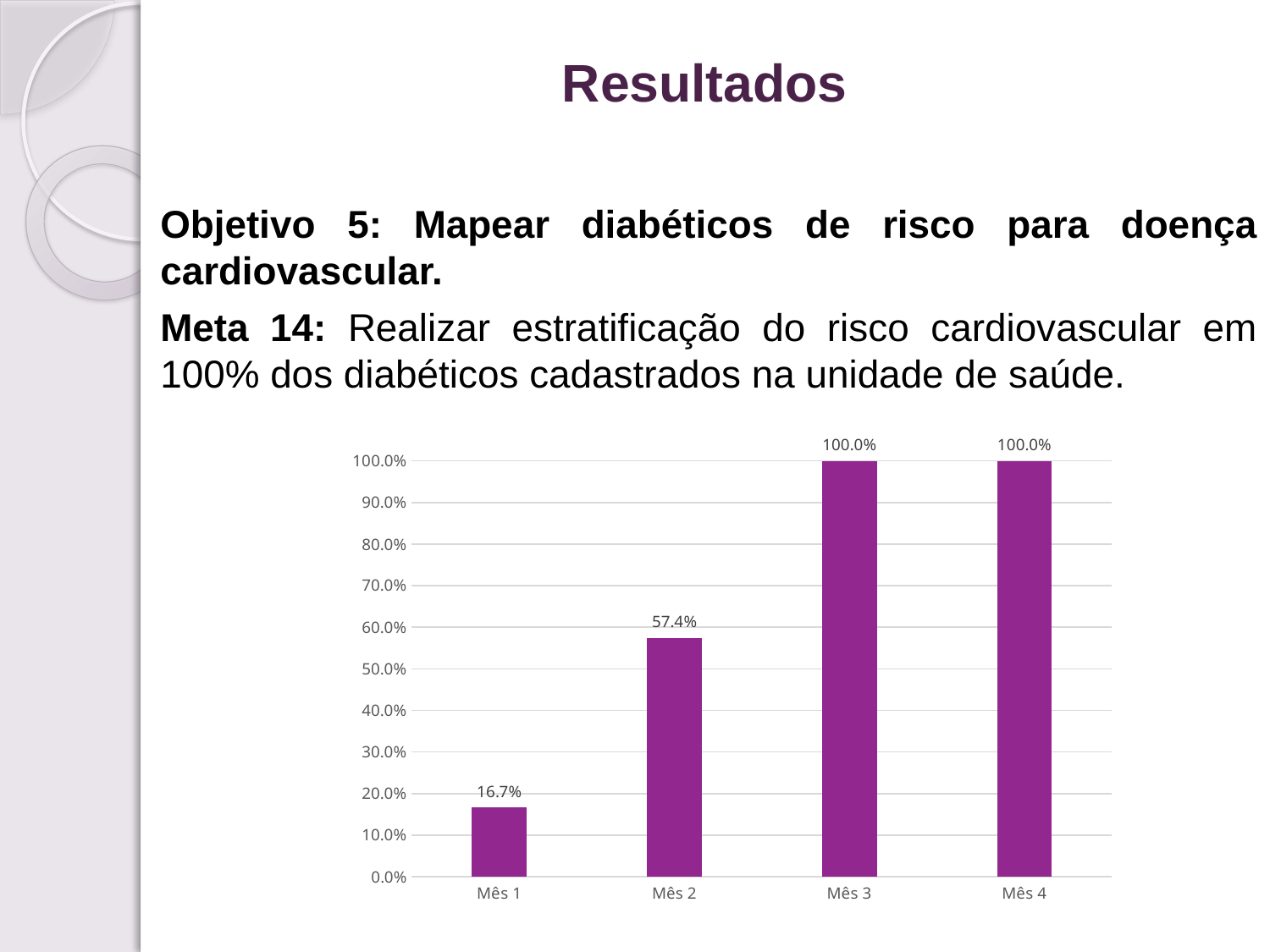
What colour are the bars in the chart? Purple Which is larger, the value for Mês 1 or the value for Mês 2? Mês 2 What is the value for Mês 3? 100.0% What is the value for Mês 1? 16.7% How many months are shown on the x axis? 4 What kind of chart is shown on the slide? Bar chart Is the value for Mês 2 greater or less than 50.0%? greater What is the difference between the values for Mês 3 and Mês 2? 42.6% Do the values rise or fall from Mês 1 to Mês 3? Rise Which month has the lowest value? Mês 1 What is the value for Mês 2? 57.4% What is the difference between the values for Mês 2 and Mês 1? 40.7%